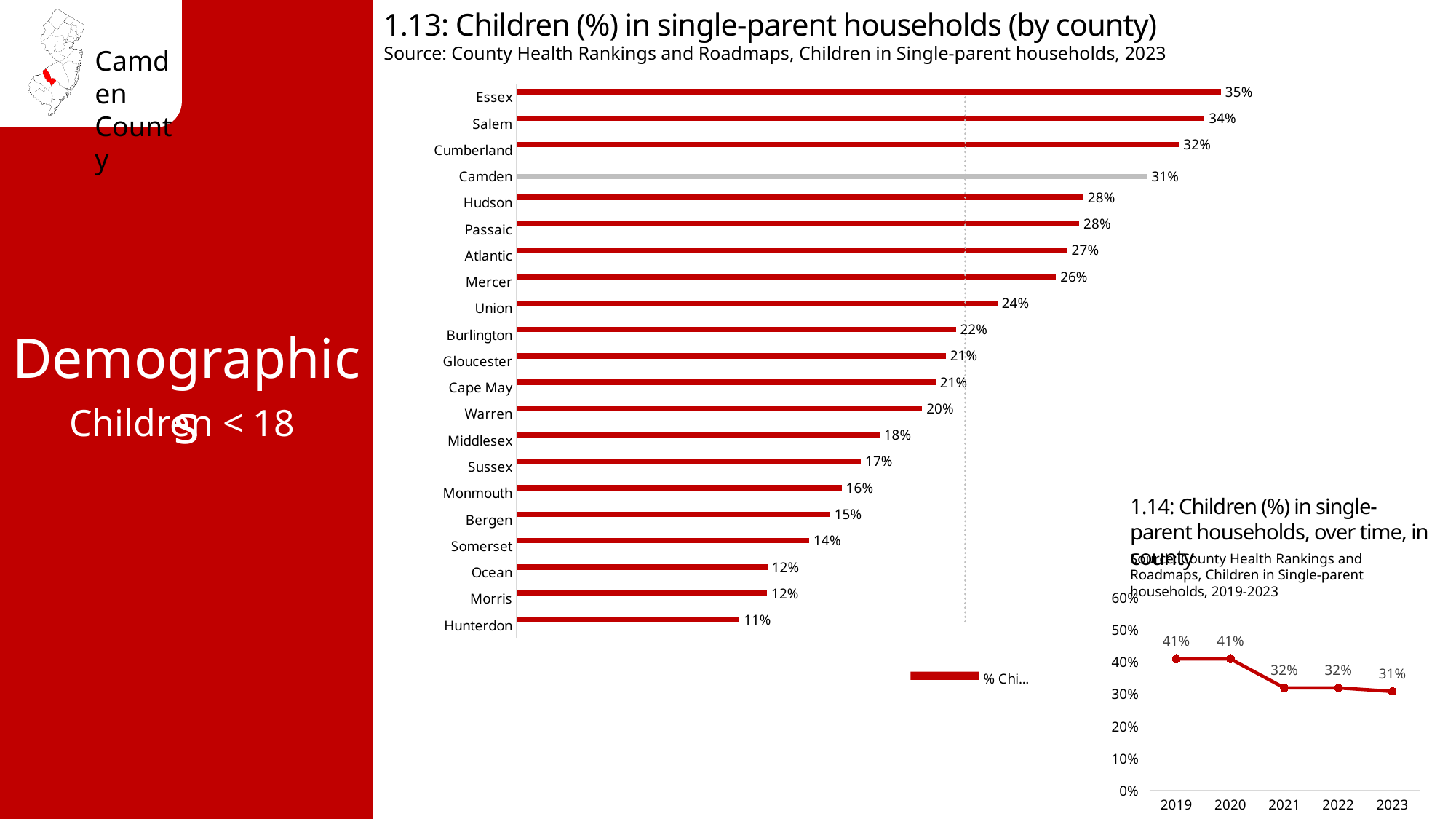
How many counties are shown in the chart '1.13: Children (%) in single-parent households (by county)'? 21 In the chart '1.13: Children (%) in single-parent households (by county)', what is the value for Mercer? 26% In the chart '1.14: Children (%) in single-parent households, over time, in county', what is the difference between the values for 2019 and 2023? 10% In the chart '1.13: Children (%) in single-parent households (by county)', which has a larger value, Union or Burlington? Union In the chart '1.13: Children (%) in single-parent households (by county)', what is the value for Camden? 31% In the chart '1.14: Children (%) in single-parent households, over time, in county', what is the value for 2021? 32% In the chart '1.14: Children (%) in single-parent households, over time, in county', do the values rise or fall from 2019 to 2023? Fall What kind of chart is '1.14: Children (%) in single-parent households, over time, in county'? Line chart In the chart '1.13: Children (%) in single-parent households (by county)', which county has the lowest value? Hunterdon In the chart '1.13: Children (%) in single-parent households (by county)', which county has the highest value? Essex What kind of chart is '1.13: Children (%) in single-parent households (by county)'? Bar chart In the chart '1.13: Children (%) in single-parent households (by county)', what is the difference between the values for Essex and Hunterdon? 24%